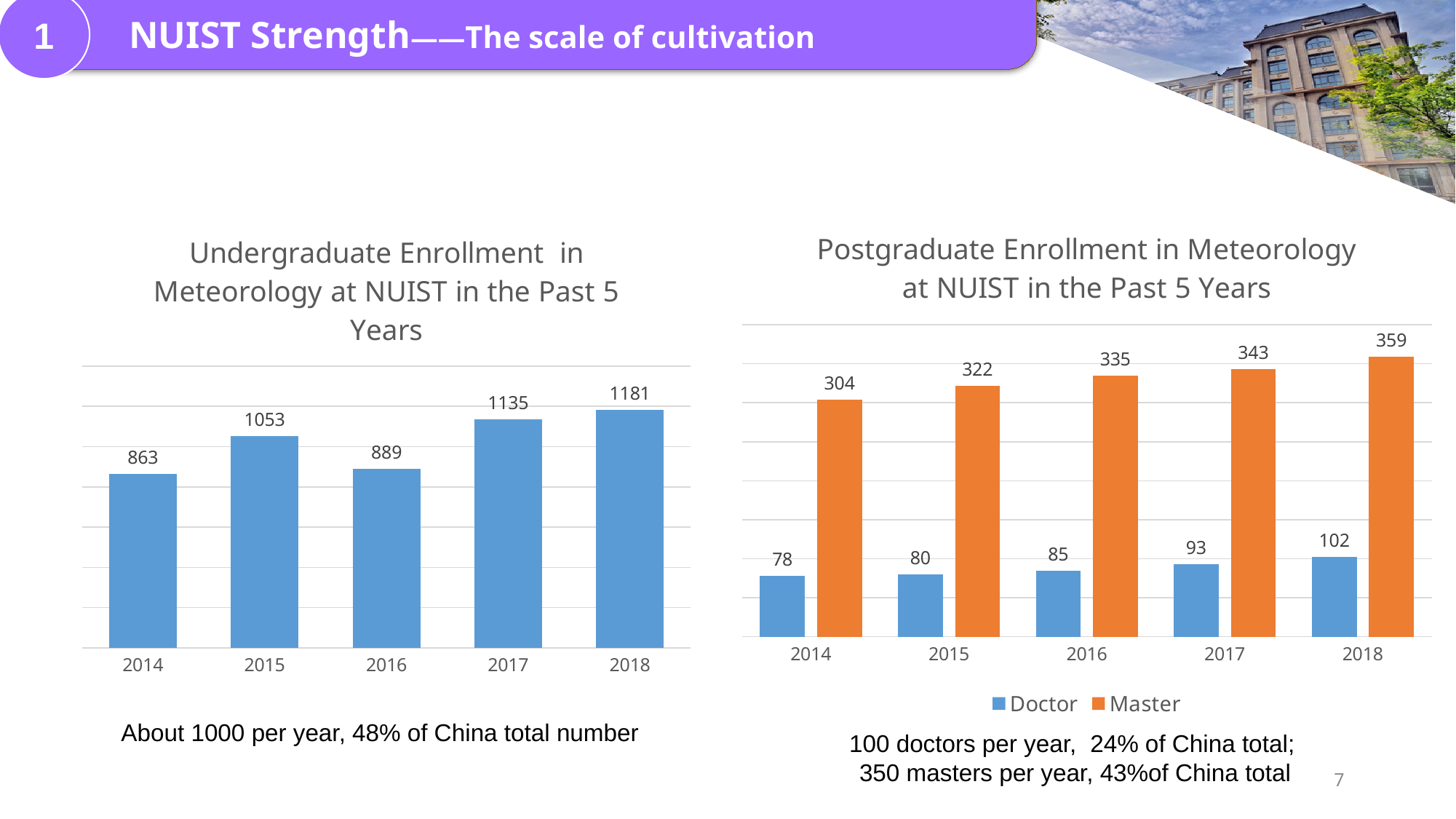
In the Postgraduate Enrollment chart, how many series does the legend list? 2 In the Undergraduate Enrollment chart, which year has the lowest enrollment? 2014 In the Postgraduate Enrollment chart, what is the Master value for 2017? 343 In the Undergraduate Enrollment chart, what is the difference between the 2018 and 2014 values? 318 In the Undergraduate Enrollment chart, what is the value for 2016? 889 In the Postgraduate Enrollment chart, which colour represents the Master series? orange In the Postgraduate Enrollment chart, what is the Doctor value for 2018? 102 What kind of chart is the Postgraduate Enrollment chart? bar chart In the Postgraduate Enrollment chart, what is the difference between the Master and Doctor values in 2014? 226 In the Undergraduate Enrollment chart, which year has the highest enrollment? 2018 In the Undergraduate Enrollment chart, how many years are shown? 5 In the Postgraduate Enrollment chart, do the Doctor values rise or fall from 2014 to 2018? rise